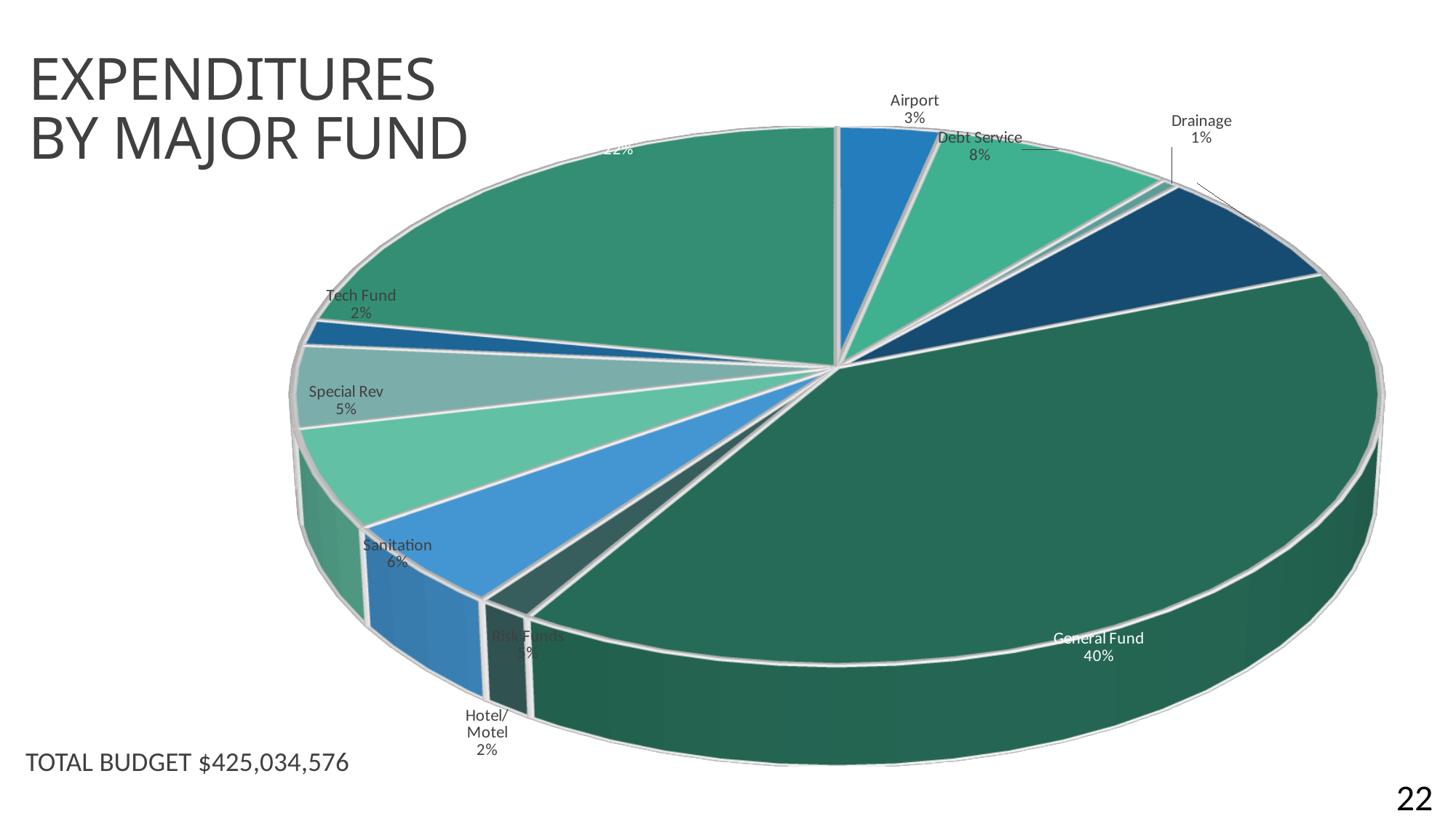
Which is larger, the Sanitation slice or the Special Rev slice? Sanitation What percentage is shown for Sanitation? 6% How many percentage points larger is the General Fund share than the Debt Service share? 32 percentage points What percentage is shown for Drainage? 1% Which fund has the largest slice of the pie? General Fund What percentage is shown for Tech Fund? 2% What percentage of expenditures does the General Fund account for? 40% What type of chart is shown on the slide? Pie chart What percentage is shown for Airport? 3% What share of the pie is Debt Service? 8% What total budget is stated on the slide? $425,034,576 What share of expenditures is Special Rev? 5%